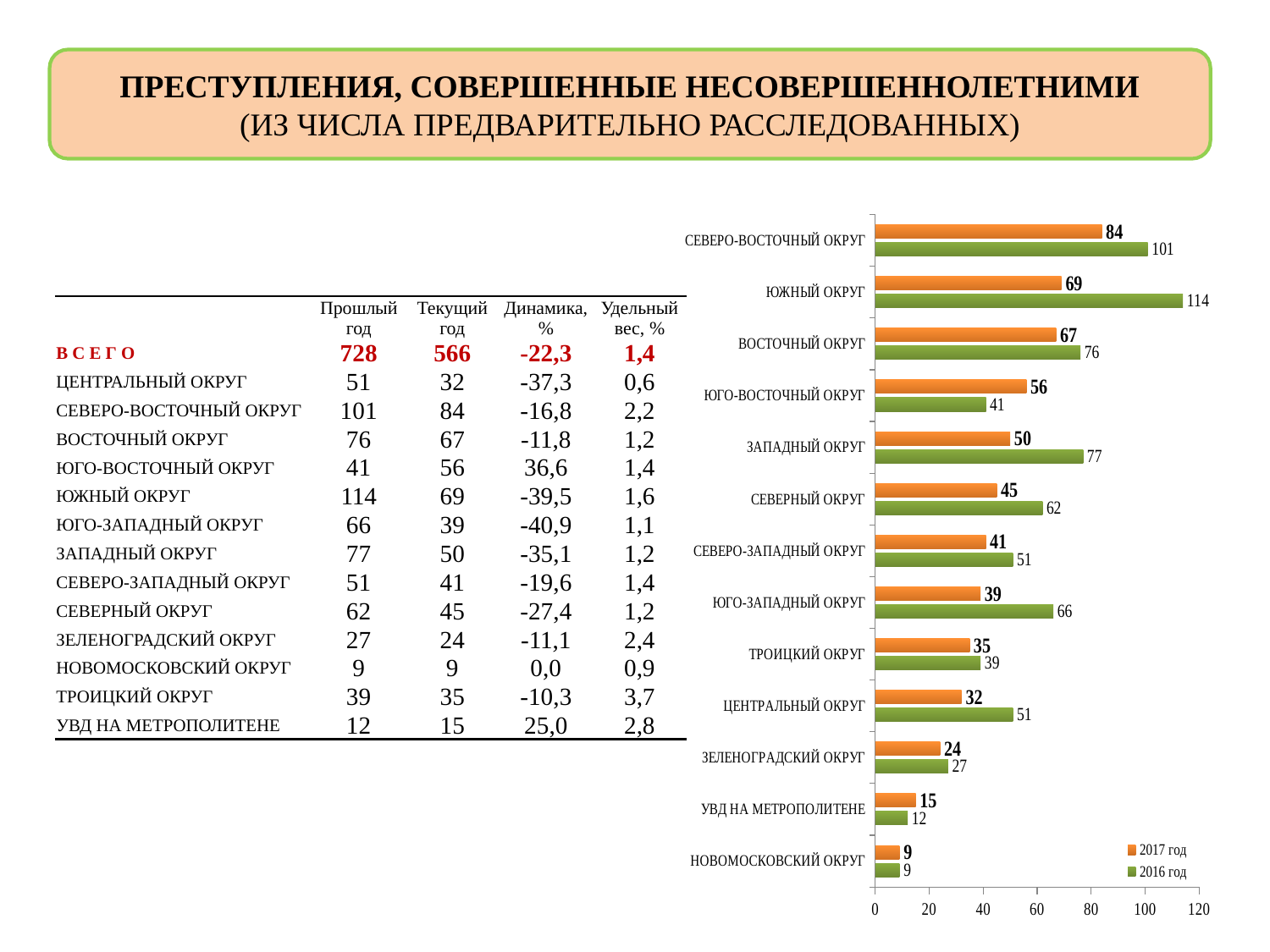
What is the difference between the 2016 год and 2017 год values for ЮЖНЫЙ ОКРУГ? 45 For ЮГО-ВОСТОЧНЫЙ ОКРУГ, which is larger: the 2017 год value or the 2016 год value? 2017 год What is the 2016 год value for ЗАПАДНЫЙ ОКРУГ on the chart? 77 Which category has the lowest 2017 год value on the chart? НОВОМОСКОВСКИЙ ОКРУГ How many categories (districts) are shown on the chart? 13 What is the 2017 год value for ЮЖНЫЙ ОКРУГ on the chart? 69 What is the 2017 год value for УВД НА МЕТРОПОЛИТЕНЕ on the chart? 15 What type of chart is shown on the slide? bar chart Which colour represents the 2016 год series on the chart? green Is the 2016 год value for СЕВЕРО-ВОСТОЧНЫЙ ОКРУГ greater or less than 100? greater How many series does the chart legend list? 2 Which category has the highest 2016 год value on the chart? ЮЖНЫЙ ОКРУГ